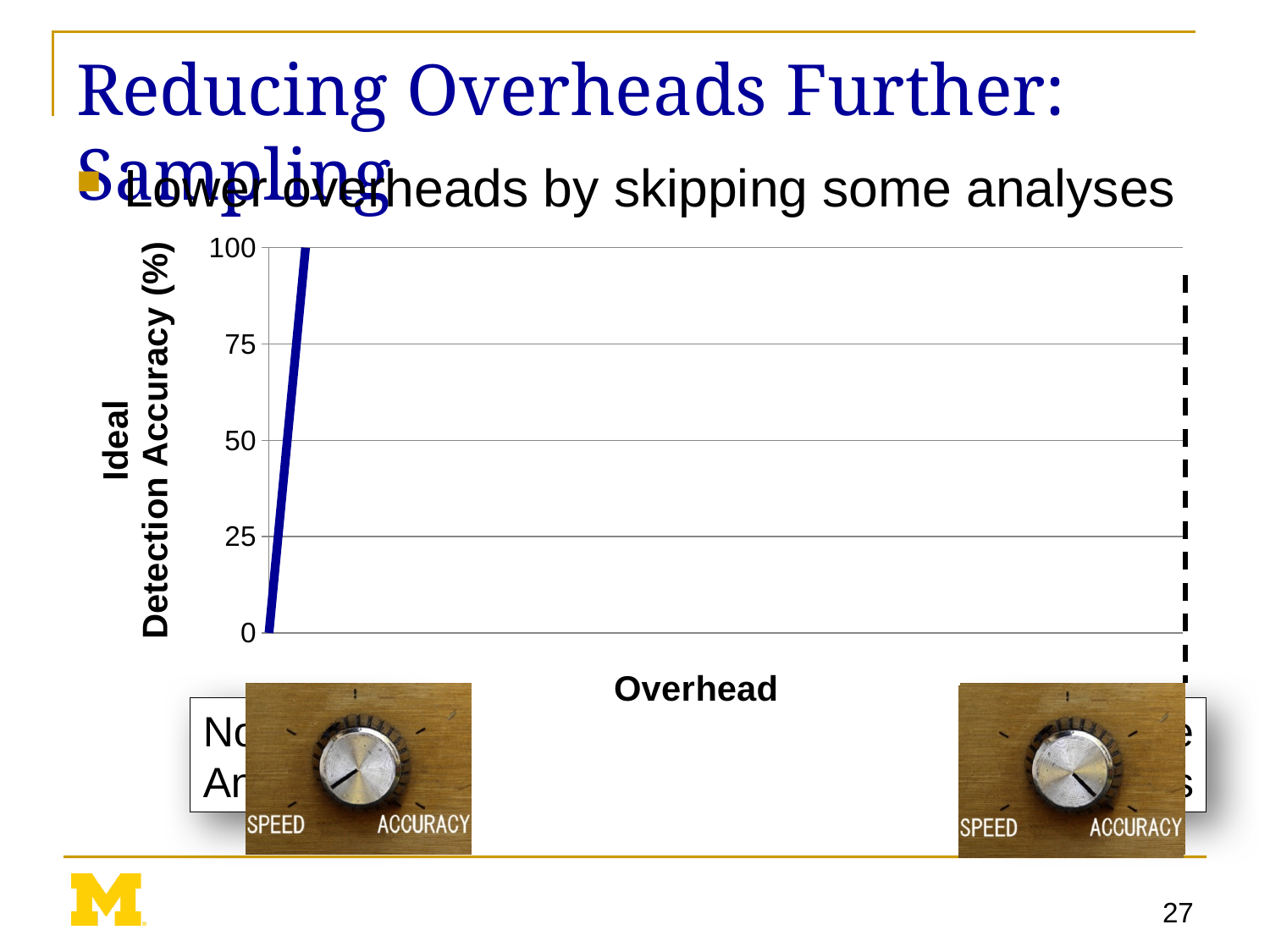
What is the label of the x axis of the chart? Overhead What is the lowest value shown on the y axis of the chart? 0 What is the label of the y axis of the chart? Detection Accuracy (%) What is the name of the plotted line in the chart? Ideal Does the Ideal line rise or fall as Overhead increases along the x axis? rise What is the highest value shown on the y axis of the chart? 100 What kind of chart is shown on the slide? line chart